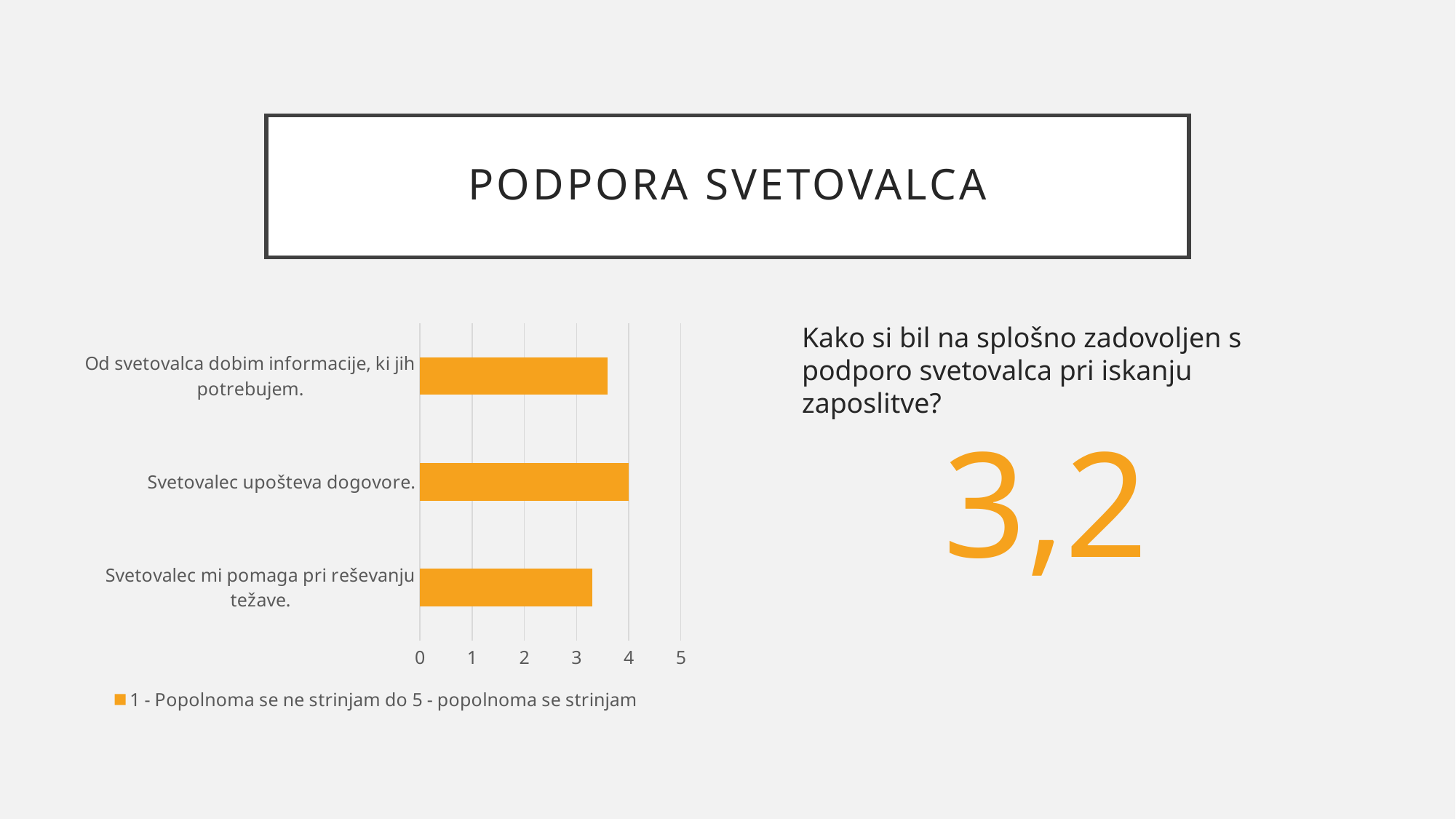
What is the highest value shown on the chart's value axis? 5 Is the value for "Od svetovalca dobim informacije, ki jih potrebujem." greater or less than 4? less Is the value for "Od svetovalca dobim informacije, ki jih potrebujem." greater or less than 3? greater What is the value for "Svetovalec upošteva dogovore."? 4 Which category has the highest value? Svetovalec upošteva dogovore. What kind of chart is shown on the slide? bar chart What is the legend entry of the chart? 1 - Popolnoma se ne strinjam do 5 - popolnoma se strinjam Is the value for "Svetovalec mi pomaga pri reševanju težave." greater or less than 4? less How many categories does the bar chart show? 3 How many series does the chart legend list? 1 Which category has the lowest value? Svetovalec mi pomaga pri reševanju težave. Which has a larger value: "Od svetovalca dobim informacije, ki jih potrebujem." or "Svetovalec mi pomaga pri reševanju težave."? Od svetovalca dobim informacije, ki jih potrebujem.